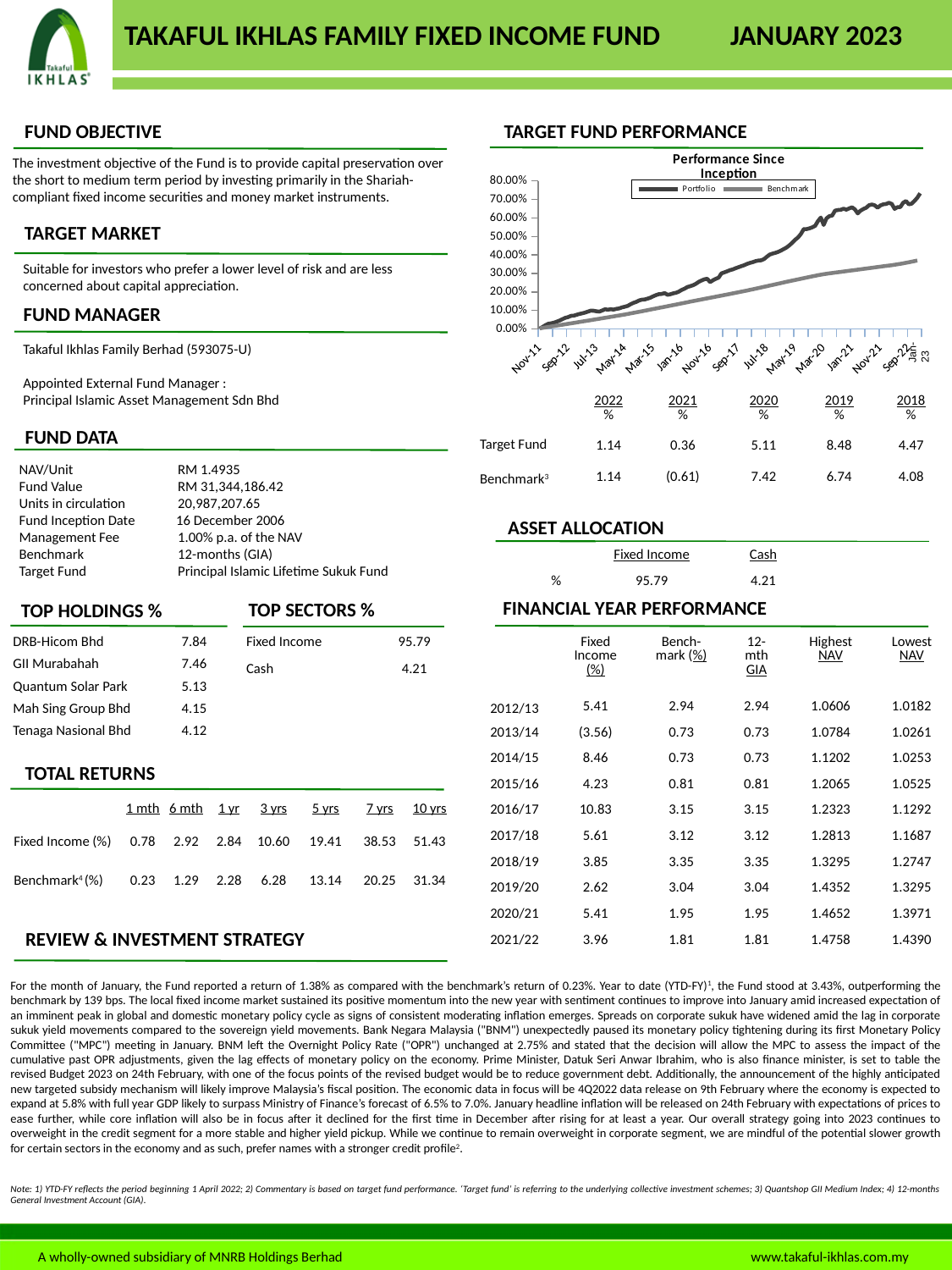
In the "Performance Since Inception" chart, is the Portfolio value at Jan-23 greater or less than 60.00%? greater What is the highest tick value shown on the y axis of the "Performance Since Inception" chart? 80.00% What are the two series named in the legend of the "Performance Since Inception" chart? Portfolio and Benchmark In the "Performance Since Inception" chart, is the Portfolio value at Mar-20 greater or less than 40.00%? greater What kind of chart is the "Performance Since Inception" chart? line chart In the "Performance Since Inception" chart, do the Portfolio values generally rise or fall from Nov-11 to Jan-23? rise In the "Performance Since Inception" chart, is the Portfolio value at Jan-16 greater or less than 30.00%? less How many series does the legend of the "Performance Since Inception" chart list? 2